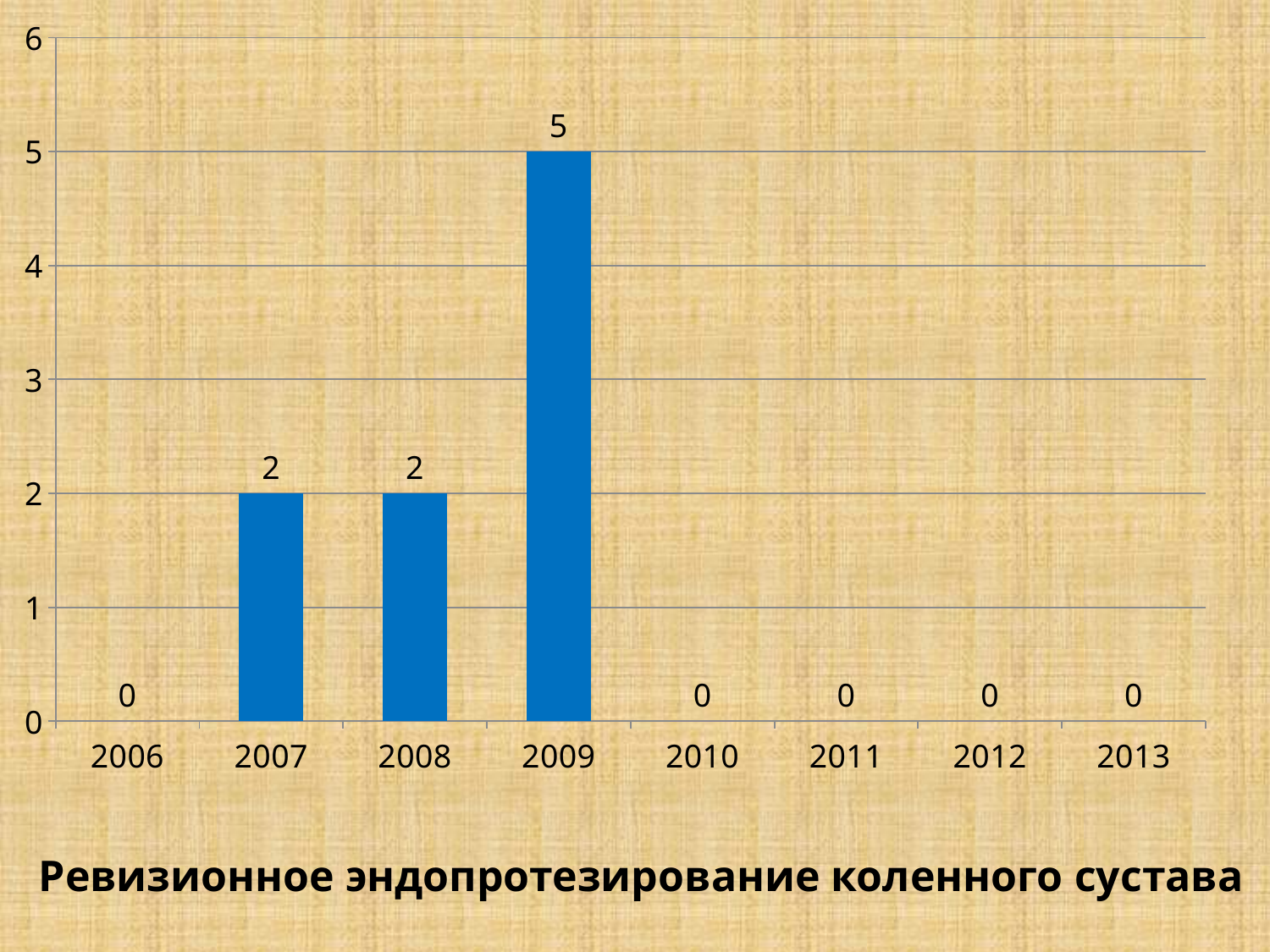
What colour are the bars? Blue How many years are shown on the x axis? 8 What is the value for 2012? 0 What is the difference between the values for 2009 and 2008? 3 What kind of chart is this? Bar chart What is the title of the chart? Ревизионное эндопротезирование коленного сустава Is the value for 2009 greater or less than 4? greater What is the value for 2007? 2 How many years have a value of 0? 5 Which is larger, the value for 2009 or the value for 2007? 2009 What is the value for 2009? 5 Which year has the highest value? 2009